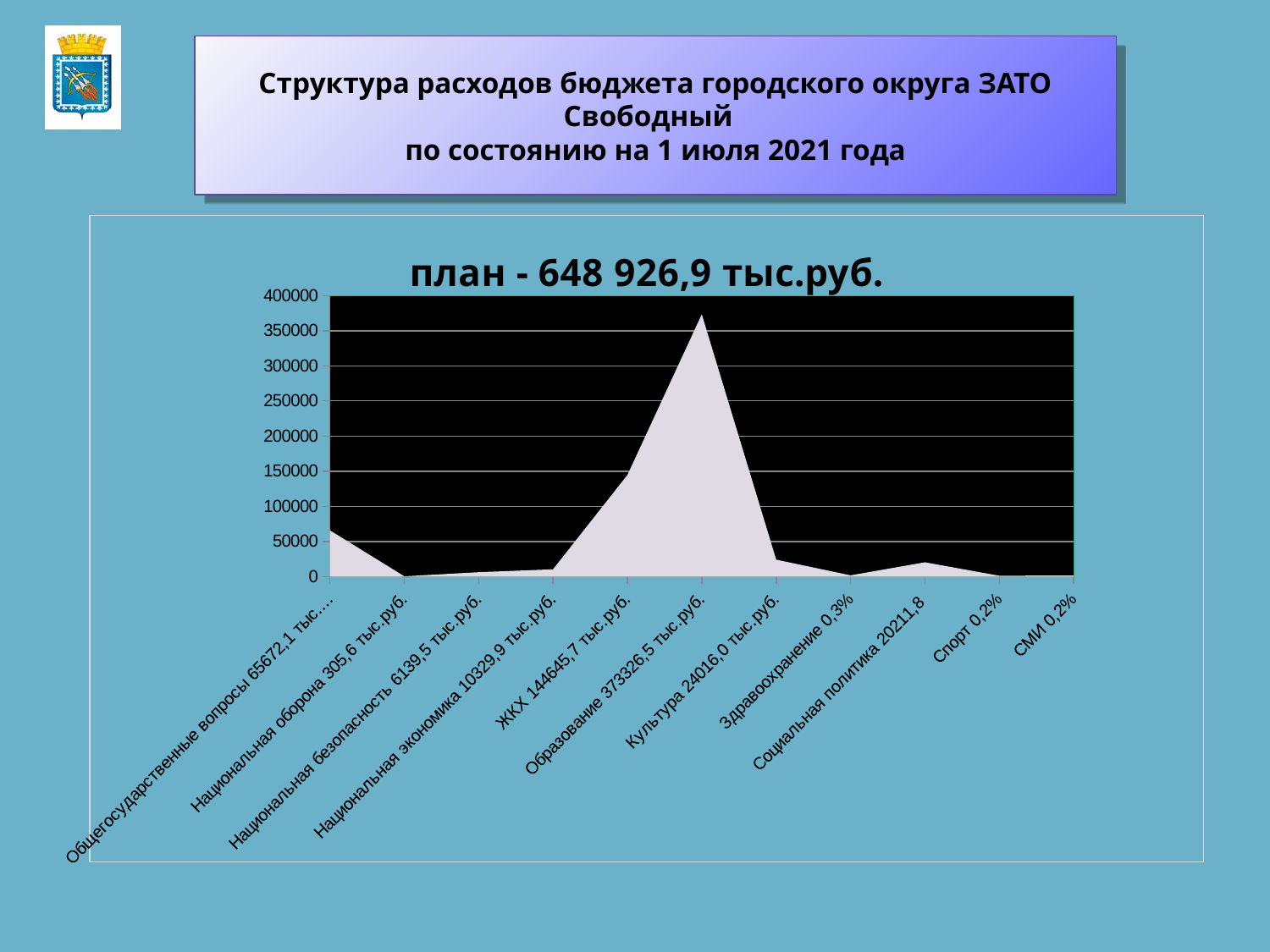
Is the value for Образование greater or less than 350000? greater Is the value for Общегосударственные вопросы greater or less than 100000? less What is the difference between the values for Образование and ЖКХ (in тыс.руб.)? 228680,8 How many expenditure categories are shown along the x axis? 11 What is the value for Национальная оборона according to its axis label? 305,6 тыс.руб. What kind of chart is shown on the slide? area chart Which category has the highest value? Образование Which is larger, the value for Общегосударственные вопросы or the value for Культура? Общегосударственные вопросы What is the value for ЖКХ according to its axis label? 144645,7 тыс.руб. What is the value for Образование according to its axis label? 373326,5 тыс.руб. What is the title of the chart? план - 648 926,9 тыс.руб. What is the value for Культура according to its axis label? 24016,0 тыс.руб.